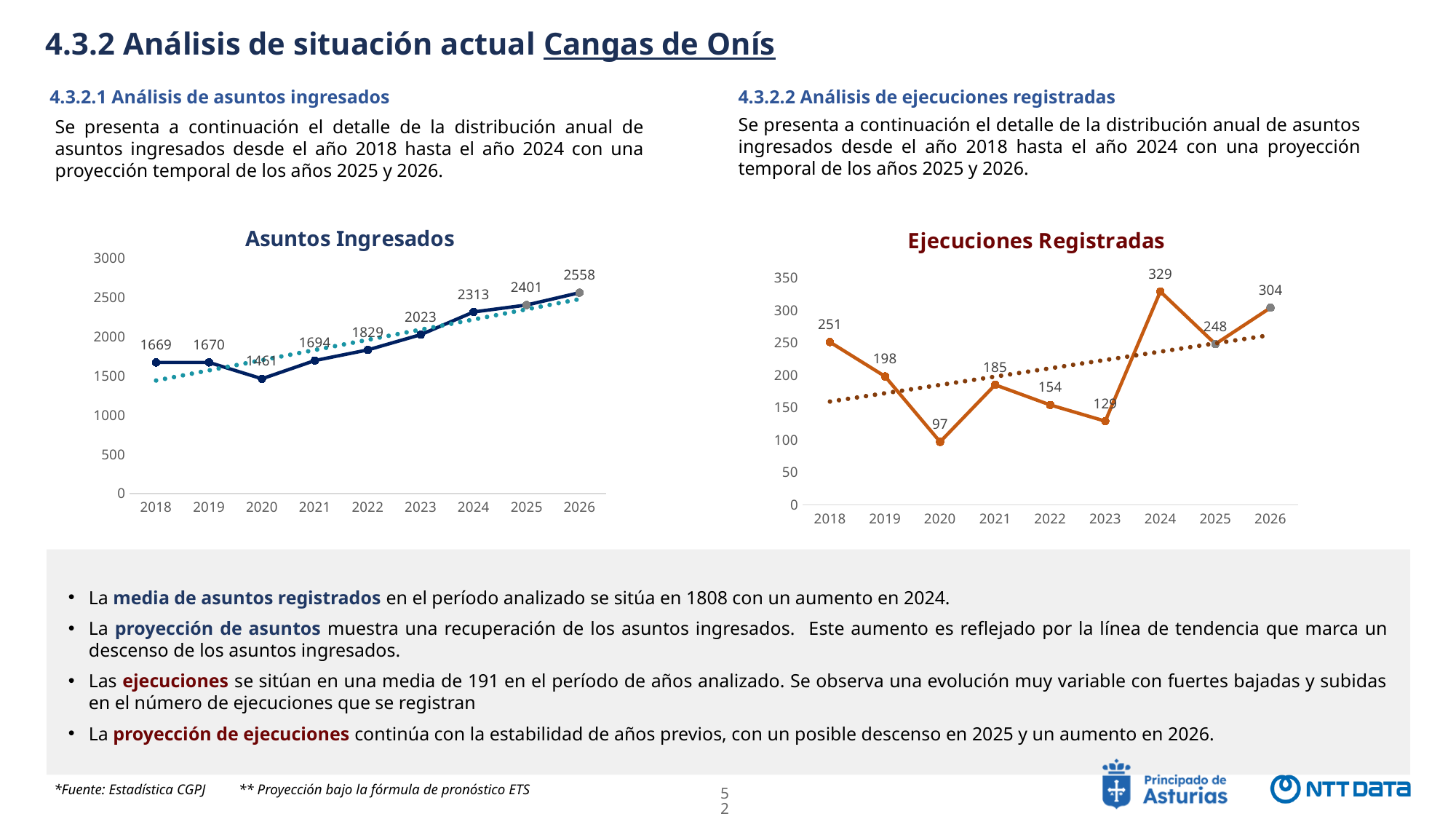
In the 'Asuntos Ingresados' chart, what is the value for 2024? 2313 In the 'Asuntos Ingresados' chart, what is the value for 2020? 1461 In the 'Asuntos Ingresados' chart, what is the difference between the values for 2026 and 2025? 157 In the 'Ejecuciones Registradas' chart, what is the value for 2020? 97 In the 'Ejecuciones Registradas' chart, which year has the highest value? 2024 What kind of chart is 'Ejecuciones Registradas'? Line chart In the 'Asuntos Ingresados' chart, which year has the highest value? 2026 In the 'Asuntos Ingresados' chart, which year has the lowest value? 2020 In the 'Asuntos Ingresados' chart, how many years are shown on the x axis? 9 In the 'Asuntos Ingresados' chart, do the values generally rise or fall from 2020 to 2026? Rise In the 'Ejecuciones Registradas' chart, what is the difference between the values for 2024 and 2023? 200 In the 'Ejecuciones Registradas' chart, which is larger, the value for 2018 or the value for 2025? 2018